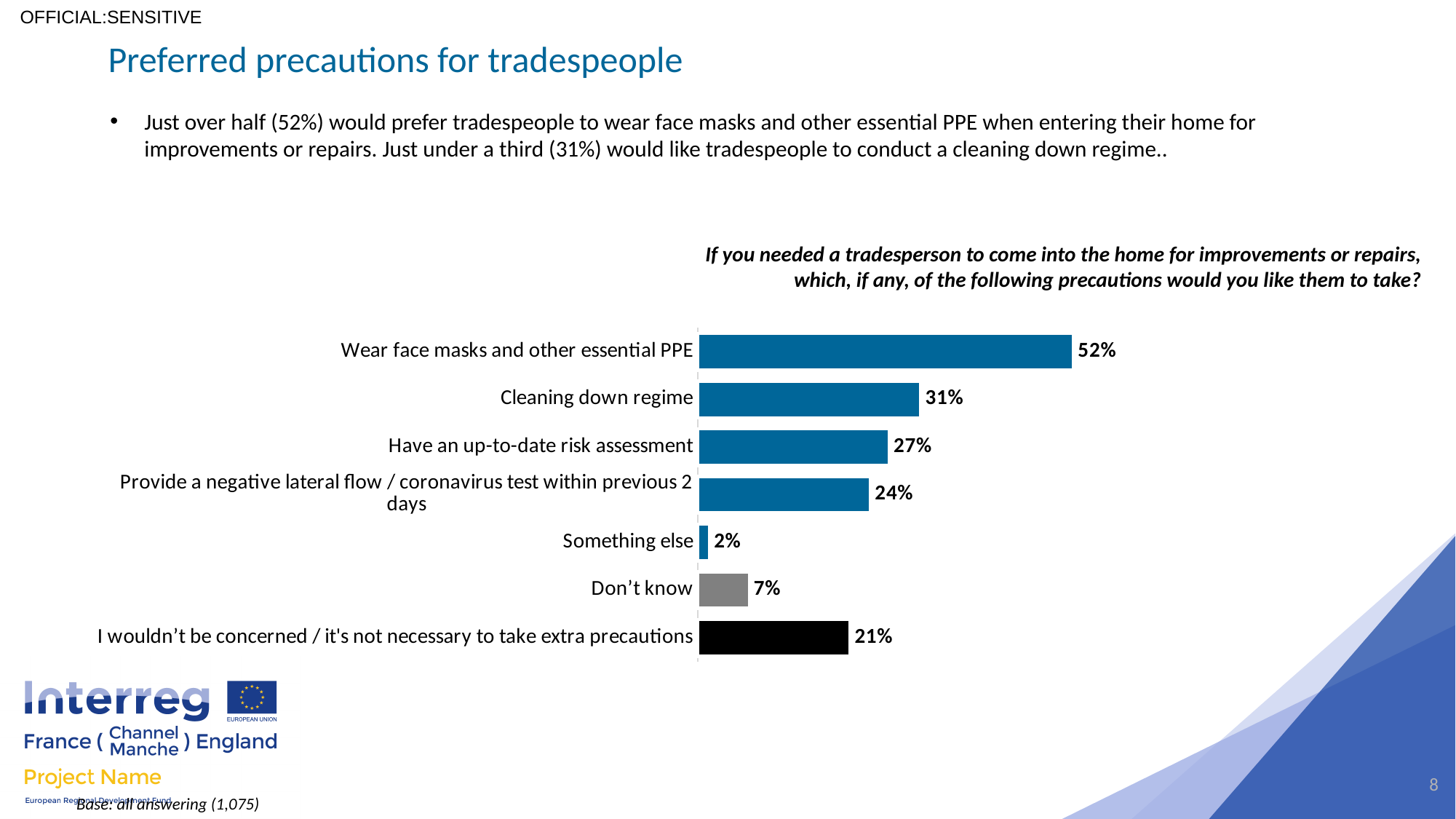
What is the difference between 'Wear face masks and other essential PPE' and 'Cleaning down regime'? 21 percentage points What colour is the bar for 'I wouldn't be concerned / it's not necessary to take extra precautions'? Black What percentage would like tradespeople to provide a negative lateral flow / coronavirus test within the previous 2 days? 24% How many categories are shown in the chart? 7 Which is larger: 'Have an up-to-date risk assessment' or 'I wouldn't be concerned / it's not necessary to take extra precautions'? Have an up-to-date risk assessment What percentage of respondents would like tradespeople to wear face masks and other essential PPE? 52% Which category has the lowest percentage? Something else What is the difference between 'I wouldn't be concerned / it's not necessary to take extra precautions' and 'Don't know'? 14 percentage points Which precaution has the highest percentage? Wear face masks and other essential PPE What type of chart is shown on the slide? Bar chart What is the value shown for 'Cleaning down regime'? 31% What is the value for 'Don't know'? 7%